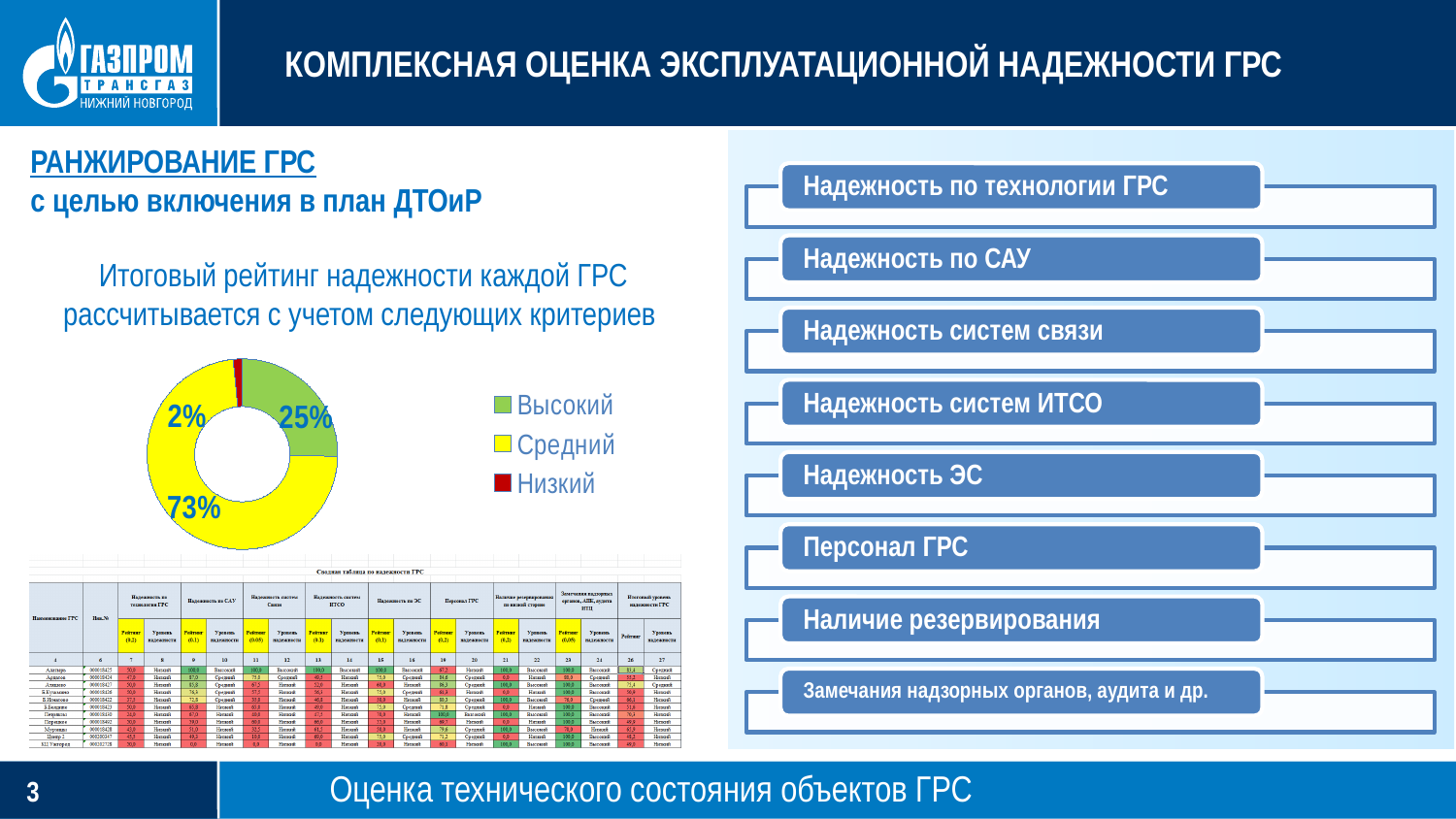
What share of the doughnut chart does the "Низкий" slice represent? 2% What colour represents the "Низкий" category in the doughnut chart? Red What share of the doughnut chart does the "Средний" slice represent? 73% Which category has the largest slice in the doughnut chart? Средний What share of the doughnut chart does the "Высокий" slice represent? 25% Which slice is larger, "Высокий" or "Низкий"? Высокий How many categories are shown in the doughnut chart? 3 How many entries does the legend of the doughnut chart list? 3 What is the difference in percentage points between the "Высокий" and "Низкий" slices? 23 What is the difference in percentage points between the "Средний" and "Высокий" slices? 48 Which category has the smallest slice in the doughnut chart? Низкий What type of chart is used to show the reliability levels on the slide? Doughnut (pie) chart